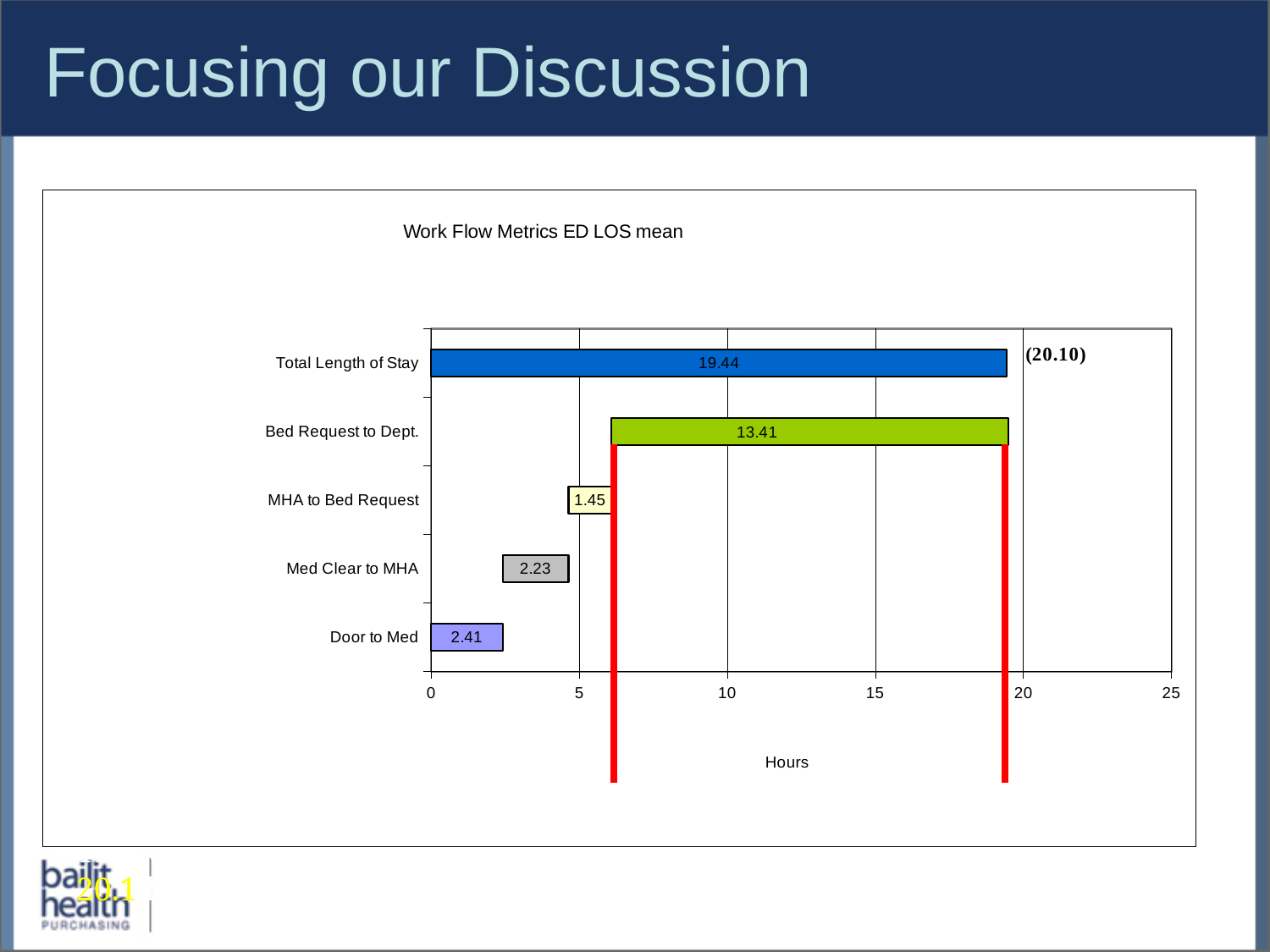
What is the value for Med Clear to MHA? 2.23 What kind of chart is shown? Bar chart Which category has the lowest value? MHA to Bed Request What is the value for Bed Request to Dept.? 13.41 What is the title of the chart? Work Flow Metrics ED LOS mean What is the value for Total Length of Stay? 19.44 Which is larger, Door to Med or Med Clear to MHA? Door to Med Which category has the highest value? Total Length of Stay What is the difference between Total Length of Stay and Bed Request to Dept.? 6.03 How many categories are shown on the chart? 5 Is the value for Bed Request to Dept. greater or less than 10? greater What is the value for Door to Med? 2.41